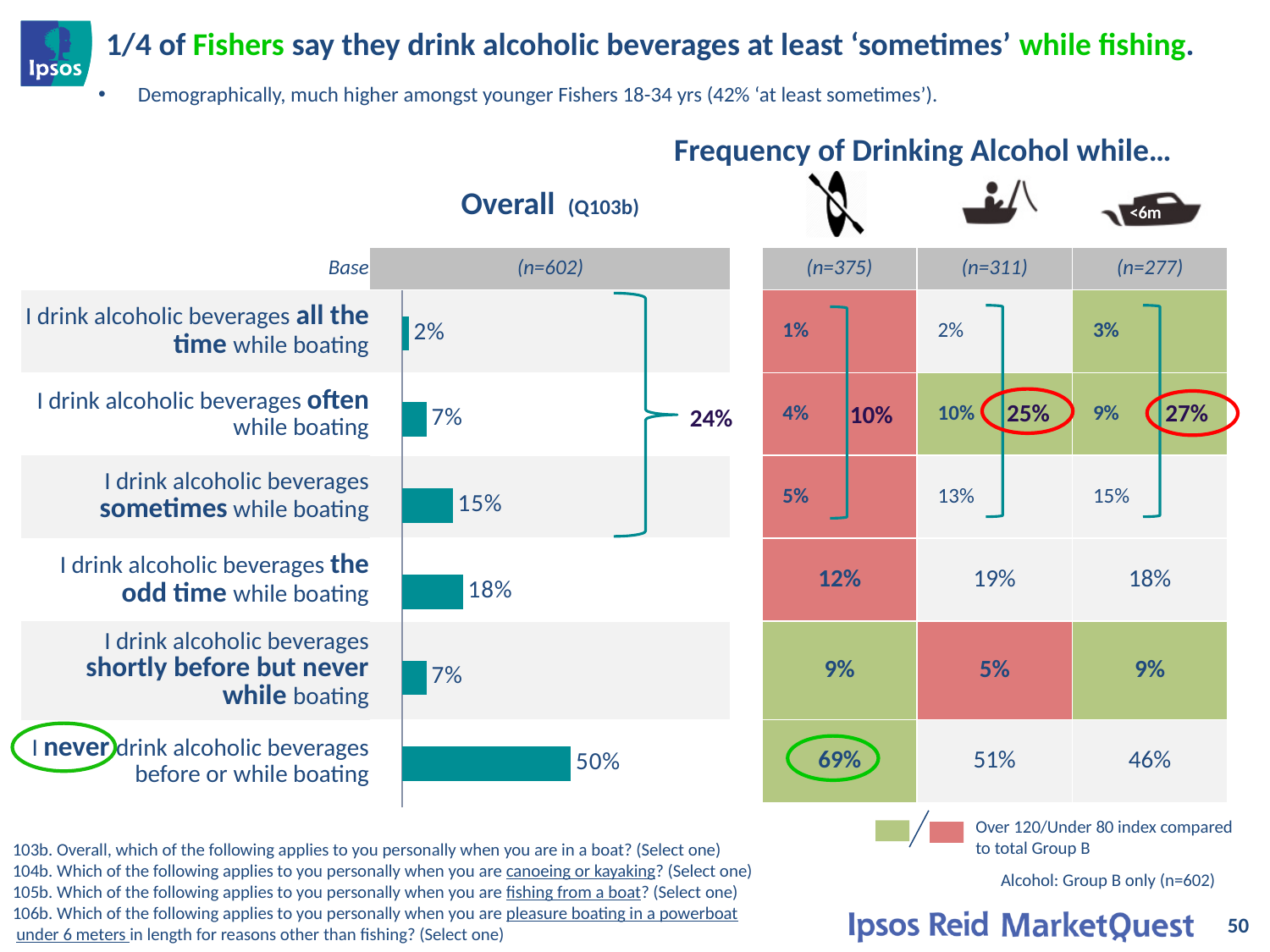
What type of chart is the Overall (Q103b) chart? bar chart In the Overall (Q103b) bar chart, what is the difference between the 'never' value and the 'the odd time' value? 32% In the Overall (Q103b) bar chart, what percentage of respondents say they never drink alcoholic beverages before or while boating? 50% In the Overall (Q103b) bar chart, which category has the highest value? I never drink alcoholic beverages before or while boating How many categories are shown in the Overall (Q103b) bar chart? 6 In the Overall (Q103b) bar chart, what is the value for 'I drink alcoholic beverages shortly before but never while boating'? 7% In the Overall (Q103b) bar chart, what is the value for 'I drink alcoholic beverages all the time while boating'? 2% In the Overall (Q103b) bar chart, which category has the lowest value? I drink alcoholic beverages all the time while boating In the Overall (Q103b) bar chart, what is the difference between the 'the odd time' value and the 'often' value? 11% In the Overall (Q103b) bar chart, which is larger: the value for 'sometimes' or the value for 'the odd time'? the odd time In the Overall (Q103b) bar chart, what combined percentage does the bracket grouping 'all the time', 'often' and 'sometimes' show? 24% In the Overall (Q103b) bar chart, what is the value for 'I drink alcoholic beverages sometimes while boating'? 15%